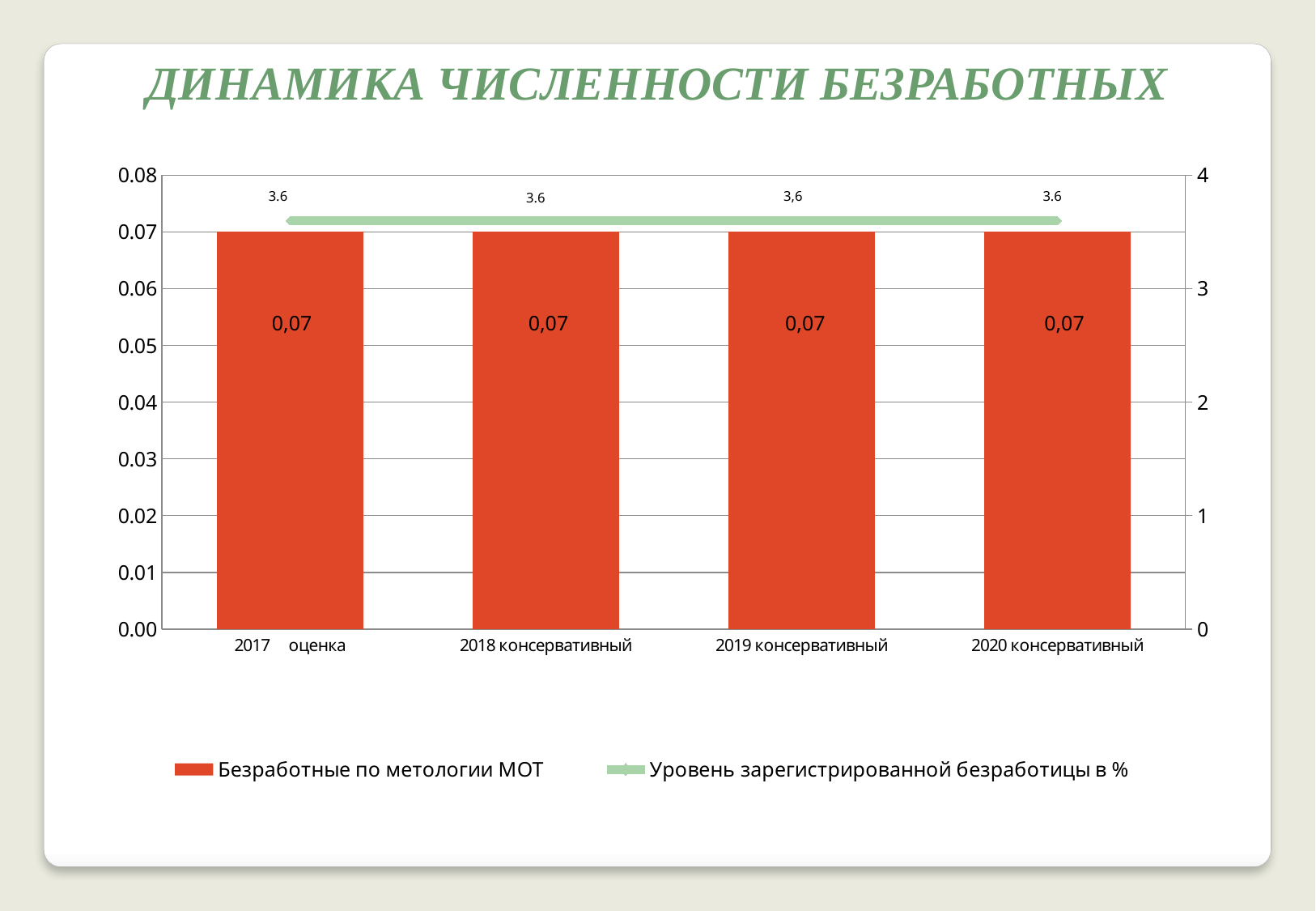
Do the bar values rise, fall or stay the same from 2017 to 2020? Stay the same Which series is shown in red in the legend? Безработные по метологии МОТ What is the difference between the bar values for 2017 оценка and 2020 консервативный? 0 What is the value of the line series (Уровень зарегистрированной безработицы в %) for 2017 оценка? 3.6 What is the title of the chart? ДИНАМИКА ЧИСЛЕННОСТИ БЕЗРАБОТНЫХ What is the value of the bar for 2018 консервативный? 0,07 Is the bar value for 2019 консервативный greater or less than 0.05? greater How many series does the legend list? 2 What is the value of the line series for 2019 консервативный? 3,6 What kind of chart is shown on the slide? Combined bar and line chart What is the value of the bar for 2020 консервативный? 0,07 How many categories are shown on the x axis? 4